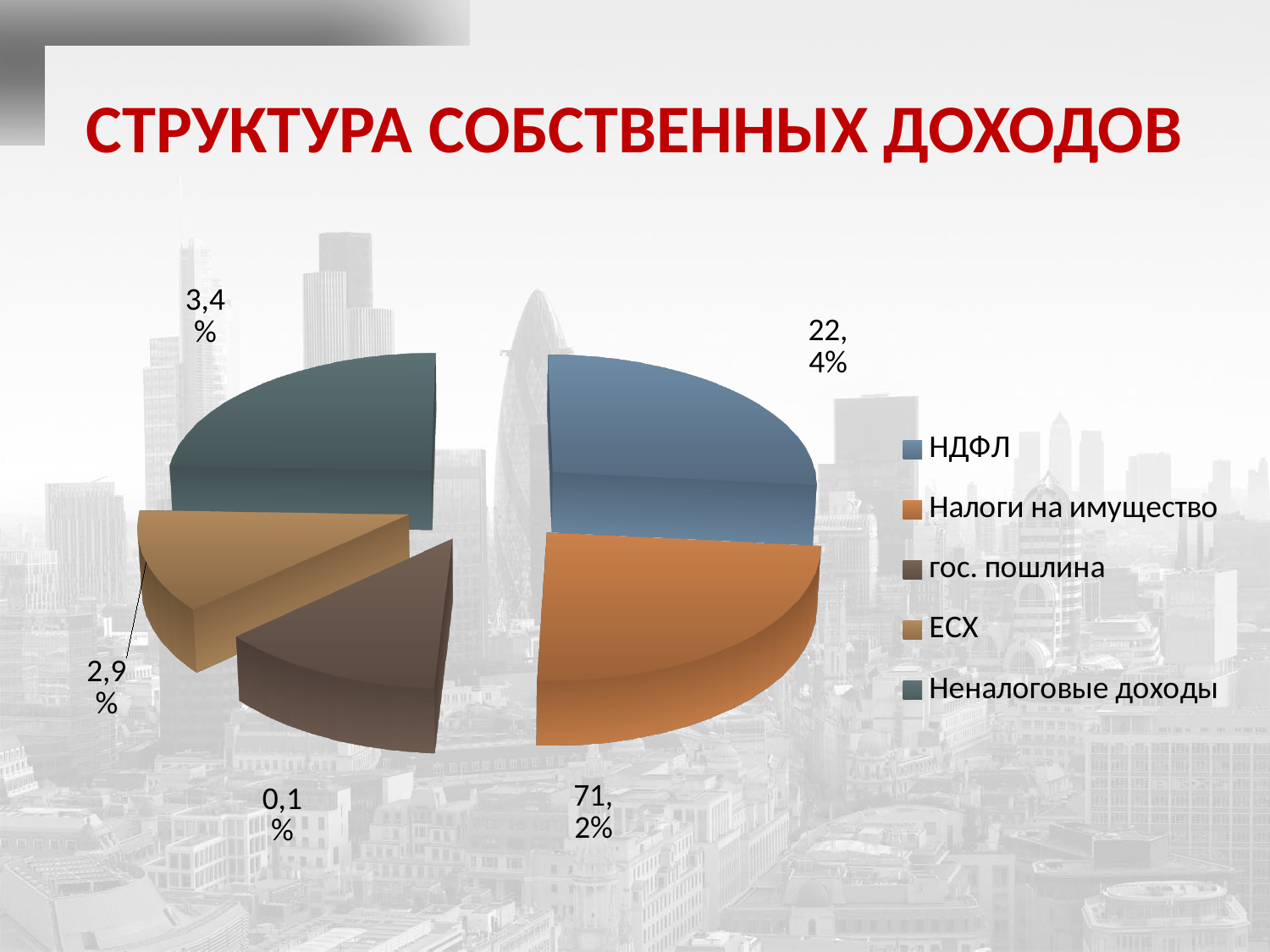
What share of the pie does Неналоговые доходы have? 3,4% Which category has the largest share of the pie? Налоги на имущество Which is larger, the share for ЕСХ or the share for Неналоговые доходы? Неналоговые доходы What share of the pie does гос. пошлина have? 0,1% What is the title of the slide? СТРУКТУРА СОБСТВЕННЫХ ДОХОДОВ What share of the pie does Налоги на имущество have? 71,2% What kind of chart is shown on the slide? Pie chart How many categories does the legend list? 5 What share of the pie does ЕСХ have? 2,9% What share of the pie does НДФЛ have? 22,4% What is the difference in percentage points between the shares of Налоги на имущество and НДФЛ? 48,8 Which category has the smallest share of the pie? гос. пошлина